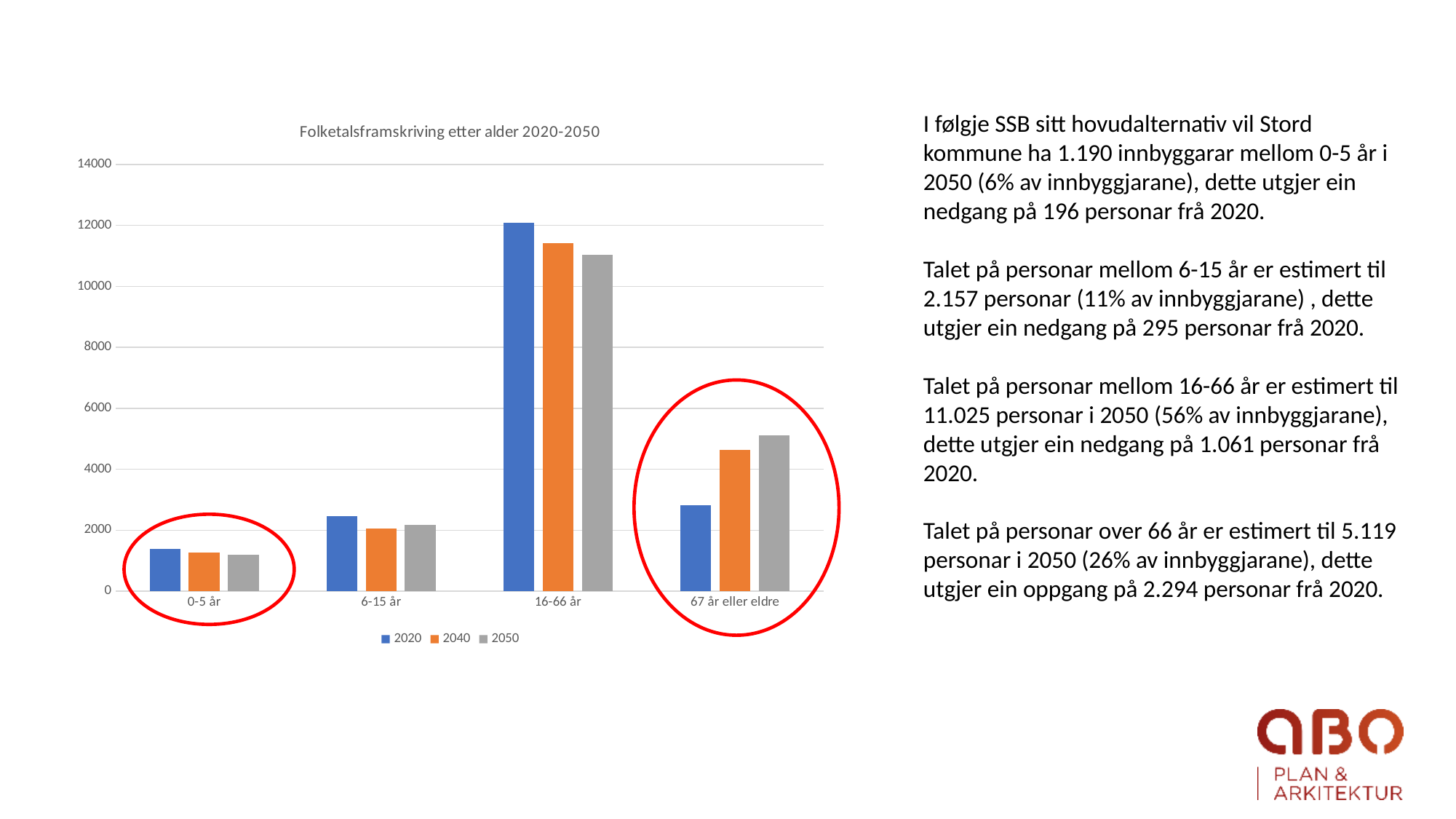
What kind of chart is shown on the slide? bar chart What is the title of the chart? Folketalsframskriving etter alder 2020-2050 How many age categories are shown on the x axis? 4 Is the 2050 value for 67 år eller eldre greater or less than 4000? greater For the 67 år eller eldre category, do the values rise or fall from 2020 to 2050? rise Which age category has the lowest bars in the chart? 0-5 år Is the 2020 value for 16-66 år greater or less than 10000? greater Which age category has the highest bars in the chart? 16-66 år Which is larger for 2050: the value for 67 år eller eldre or the value for 6-15 år? 67 år eller eldre How many series does the chart legend list? 3 Is the 2020 value for 0-5 år greater or less than 2000? less Which two age categories are circled in red on the chart? 0-5 år and 67 år eller eldre